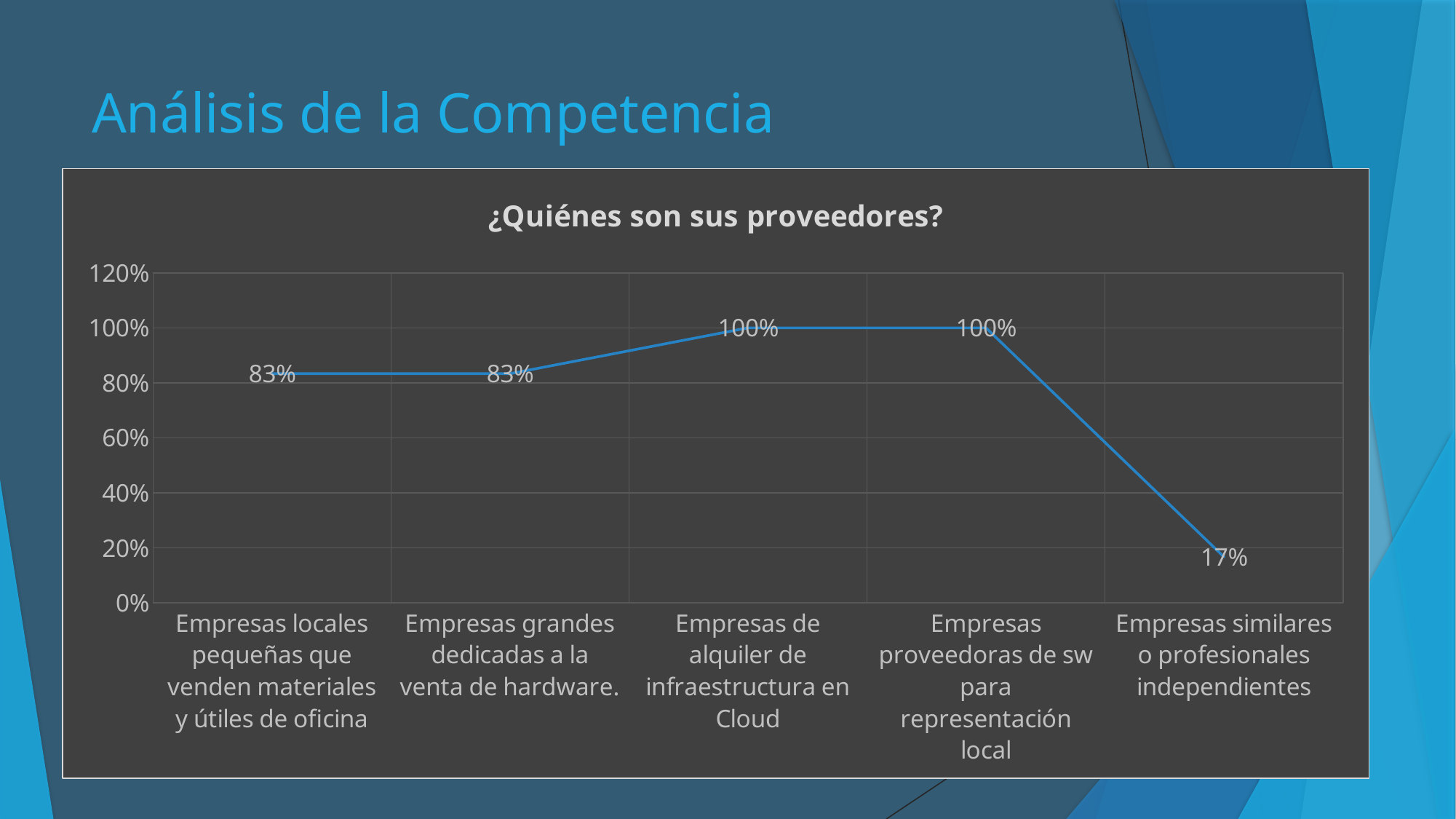
Which category has the lowest value? Empresas similares o profesionales independientes What is the value for 'Empresas locales pequeñas que venden materiales y útiles de oficina'? 83% What is the value for 'Empresas de alquiler de infraestructura en Cloud'? 100% What is the value for 'Empresas grandes dedicadas a la venta de hardware.'? 83% How many categories are shown on the x axis? 5 Is the value for 'Empresas similares o profesionales independientes' greater or less than 40%? less What kind of chart is shown on the slide? line chart What is the value for 'Empresas similares o profesionales independientes'? 17% Does the line rise or fall between 'Empresas proveedoras de sw para representación local' and 'Empresas similares o profesionales independientes'? fall What is the difference between the value for 'Empresas proveedoras de sw para representación local' and the value for 'Empresas similares o profesionales independientes'? 83% What is the title of the chart? ¿Quiénes son sus proveedores? Which is larger: the value for 'Empresas grandes dedicadas a la venta de hardware.' or the value for 'Empresas de alquiler de infraestructura en Cloud'? Empresas de alquiler de infraestructura en Cloud